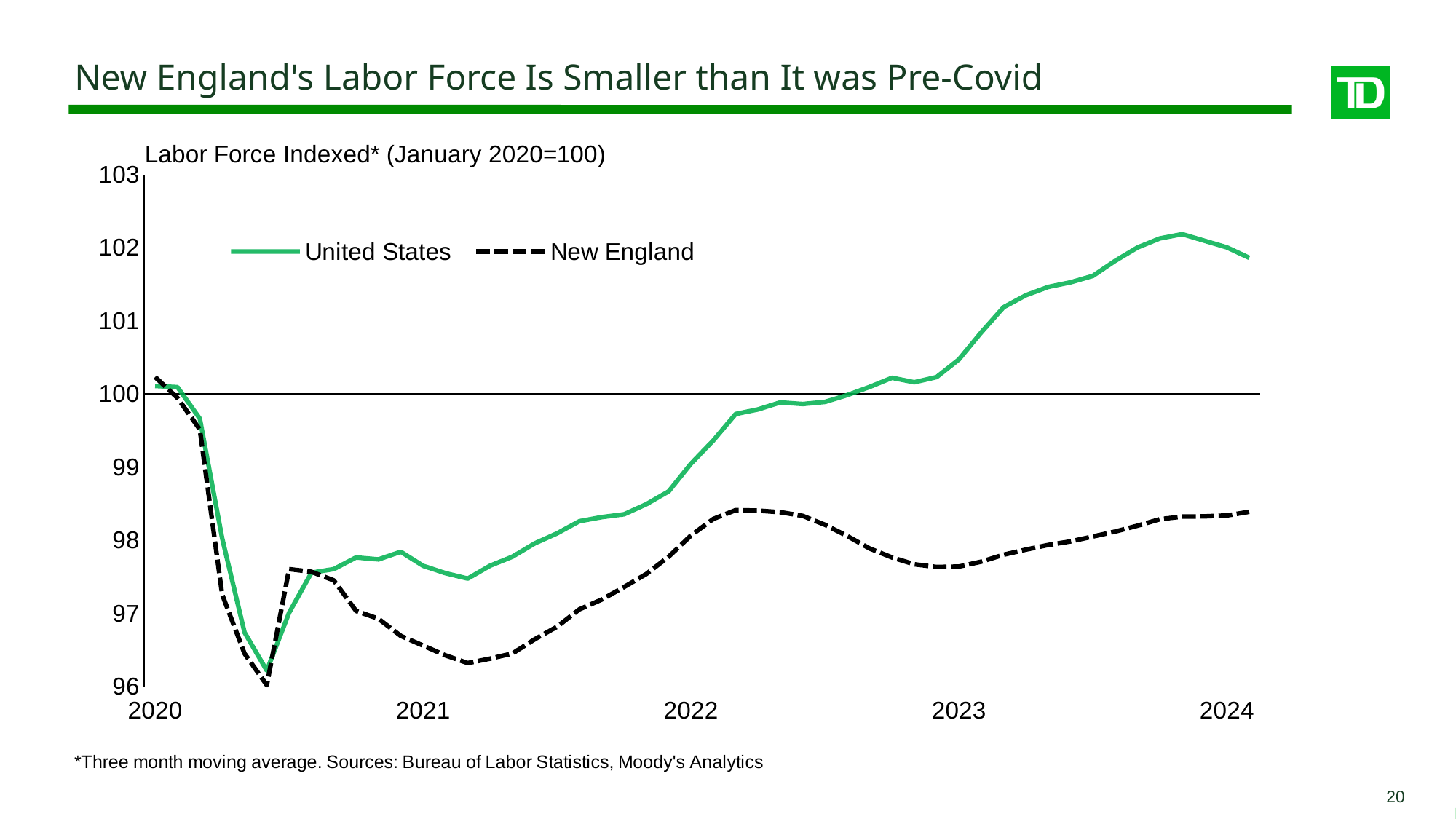
Is the value for United States at 2024 greater or less than 101? greater Is the value for New England at 2023 greater or less than 98? less What kind of chart is shown on the slide? Line chart Which two series are shown in the legend? United States and New England At 2024, which series has the higher value, United States or New England? United States Is the value for United States at 2022 greater or less than 98? greater Does the New England line rise or fall between 2023 and 2024? Rise How many series does the legend list? 2 What is the chart's title? Labor Force Indexed* (January 2020=100) In which year does the New England line reach its lowest point? 2020